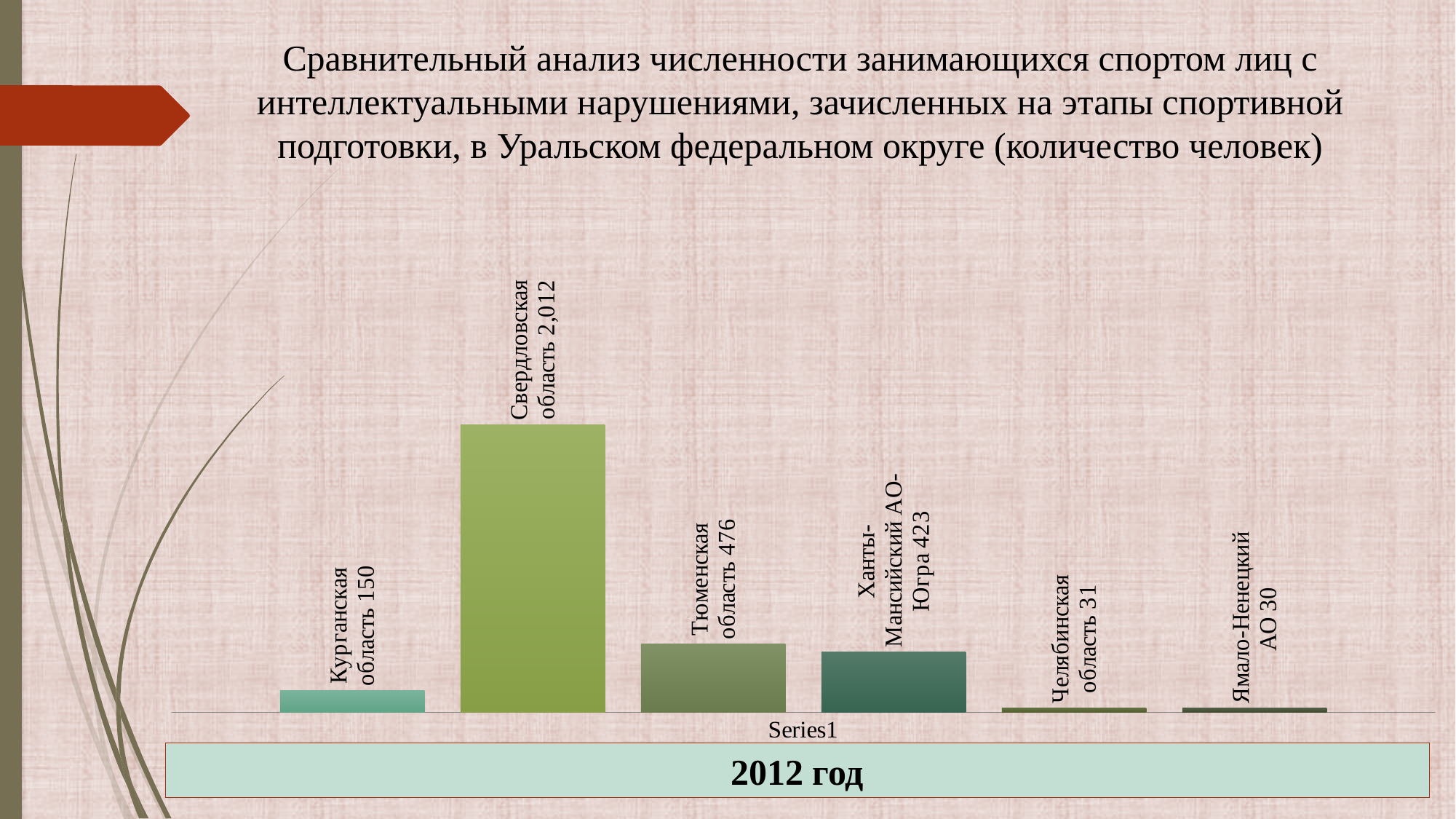
What is the value shown for Тюменская область? 476 Which region has the highest value in the chart? Свердловская область What is the value shown for Ханты-Мансийский АО-Югра? 423 Which region has the lowest value in the chart? Ямало-Ненецкий АО What year is indicated in the box below the chart? 2012 год Which is larger, the value for Курганская область or the value for Челябинская область? Курганская область What type of chart is shown on the slide? bar chart What is the difference between the values for Челябинская область and Ямало-Ненецкий АО? 1 What is the difference between the values for Тюменская область and Ханты-Мансийский АО-Югра? 53 What is the value shown for Свердловская область? 2,012 What is the value shown for Курганская область? 150 How many bars are plotted in the chart? 6